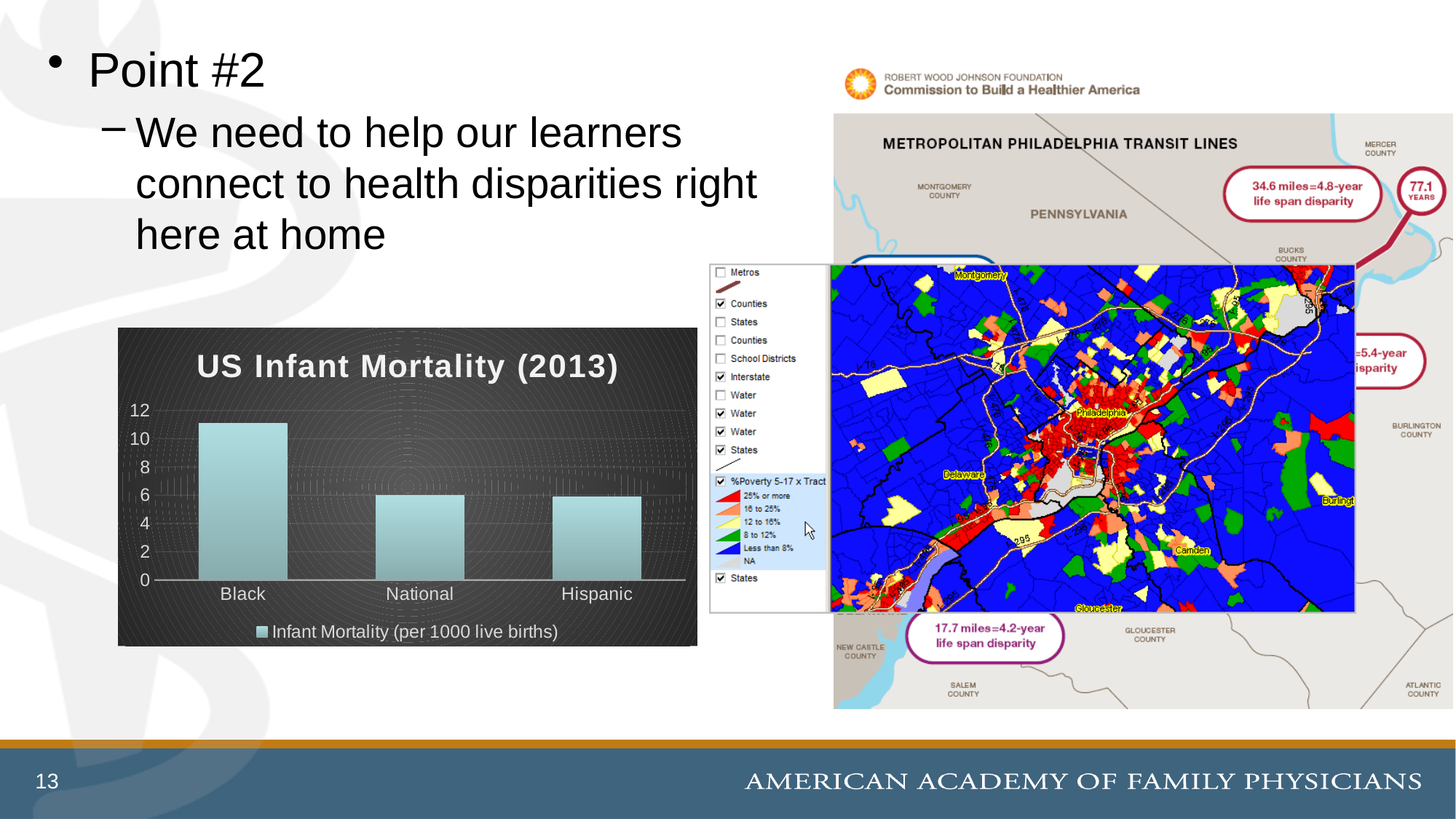
What series name does the legend of the US Infant Mortality (2013) chart show? Infant Mortality (per 1000 live births) In the US Infant Mortality (2013) chart, is the value for Black greater or less than 10? greater What kind of chart is the US Infant Mortality (2013) chart? bar chart In the US Infant Mortality (2013) chart, which is larger, the value for Black or the value for National? Black Which category has the highest value in the US Infant Mortality (2013) chart? Black In the US Infant Mortality (2013) chart, is the value for National greater or less than 8? less What is the title of the bar chart on the slide? US Infant Mortality (2013) In the US Infant Mortality (2013) chart, is the value for Hispanic greater or less than 8? less How many series does the legend of the US Infant Mortality (2013) chart list? 1 How many categories are shown on the x axis of the US Infant Mortality (2013) chart? 3 In the US Infant Mortality (2013) chart, which is larger, the value for Hispanic or the value for Black? Black